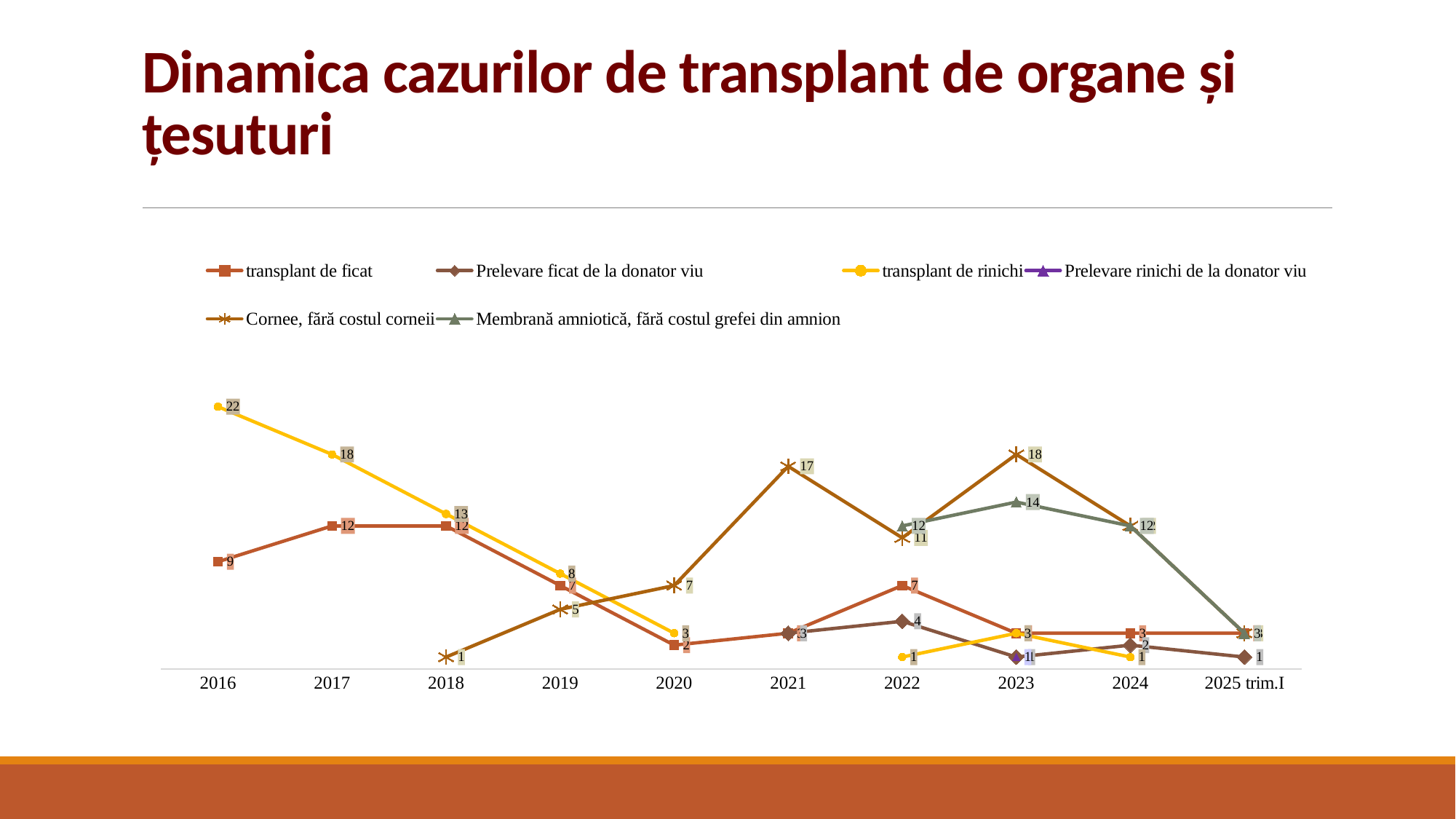
What is the value for 'transplant de rinichi' in 2016? 22 What kind of chart is shown on the slide? line chart What is the value for 'Membrană amniotică, fără costul grefei din amnion' in 2023? 14 In which year does 'Cornee, fără costul corneii' reach its highest value? 2023 Does the 'transplant de rinichi' series rise or fall from 2016 to 2020? fall What is the value for 'Cornee, fără costul corneii' in 2023? 18 How many categories are shown on the x axis? 10 In which year does 'transplant de rinichi' reach its highest value? 2016 What is the value for 'transplant de ficat' in 2017? 12 How many series does the legend list? 6 What is the difference between the 'transplant de rinichi' values for 2016 and 2017? 4 In 2021, which is larger: 'Cornee, fără costul corneii' or 'transplant de ficat'? Cornee, fără costul corneii